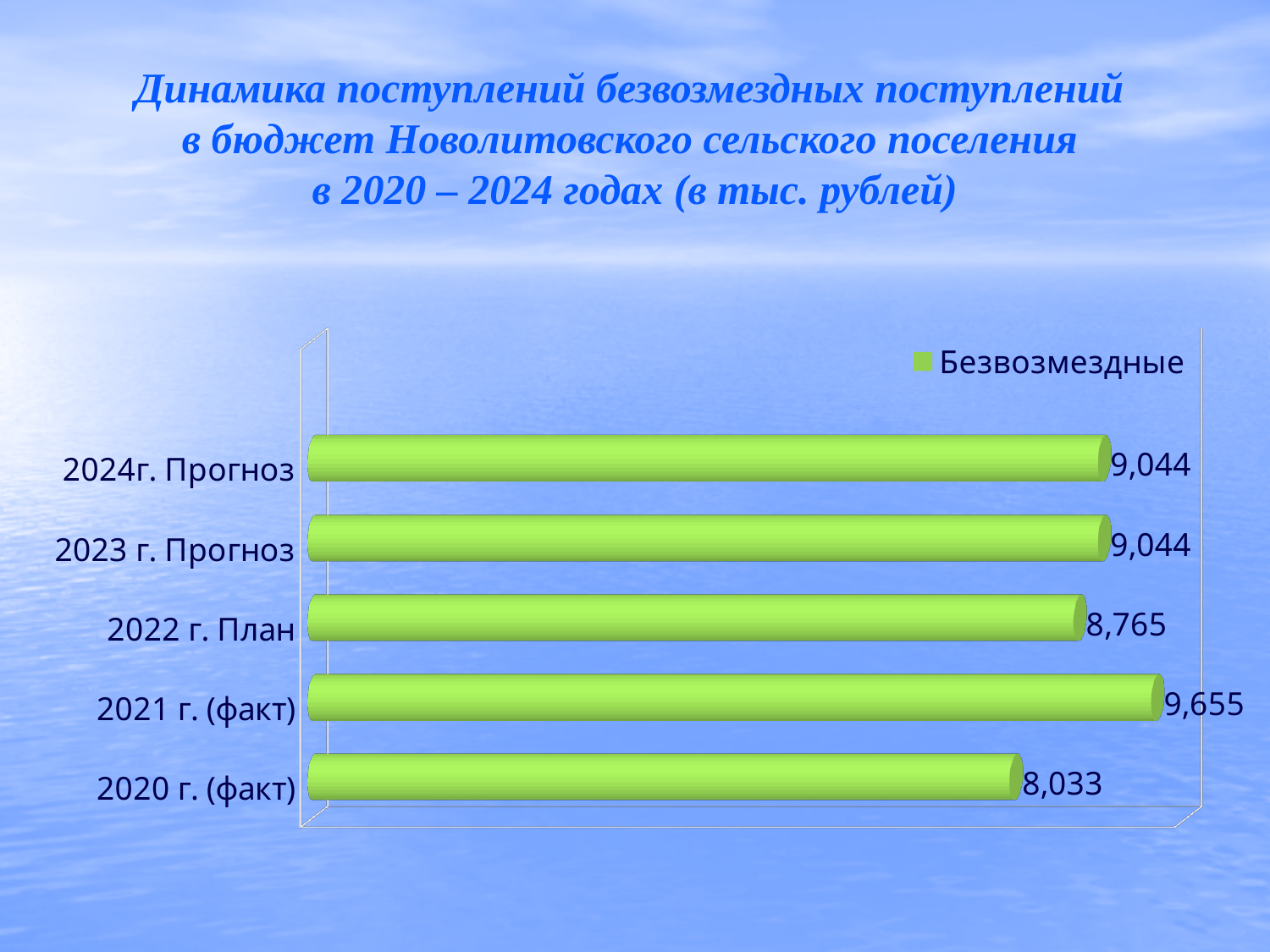
Which category has the lowest value? 2020 г. (факт) How many categories are shown in the chart? 5 What is the difference between the values for 2021 г. (факт) and 2020 г. (факт)? 1,622 Which is larger, the value for 2022 г. План or the value for 2021 г. (факт)? 2021 г. (факт) What is the value for 2020 г. (факт)? 8,033 What is the value for 2022 г. План? 8,765 Which category has the highest value? 2021 г. (факт) How many series does the legend list? 1 What is the difference between the values for 2023 г. Прогноз and 2022 г. План? 0,279 What is the value for 2021 г. (факт)? 9,655 What kind of chart is shown on the slide? Bar chart What is the value for 2023 г. Прогноз? 9,044